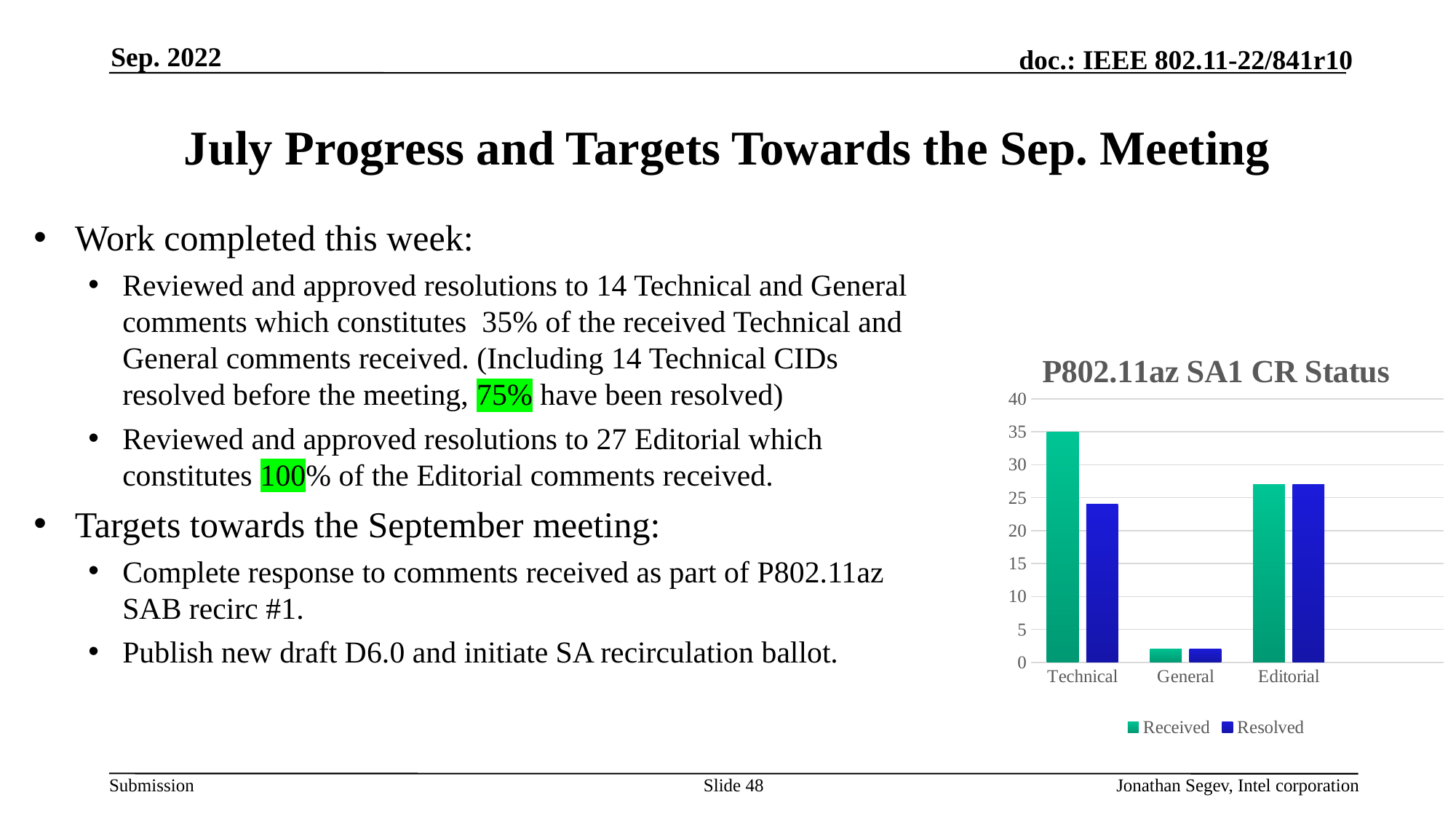
For Technical, which is larger: Received or Resolved? Received Which series is shown in dark blue in the chart? Resolved Which category has the lowest Received value? General Which category has the highest Received value? Technical How many series does the chart legend list? 2 Which category has the lowest Resolved value? General What kind of chart is shown on the slide? bar chart How many categories are shown on the x axis of the chart? 3 What is the title of the chart? P802.11az SA1 CR Status Is the Received value for Editorial greater or less than 25? greater Is the Received value for General greater or less than 5? less Is the Resolved value for Technical greater or less than 20? greater